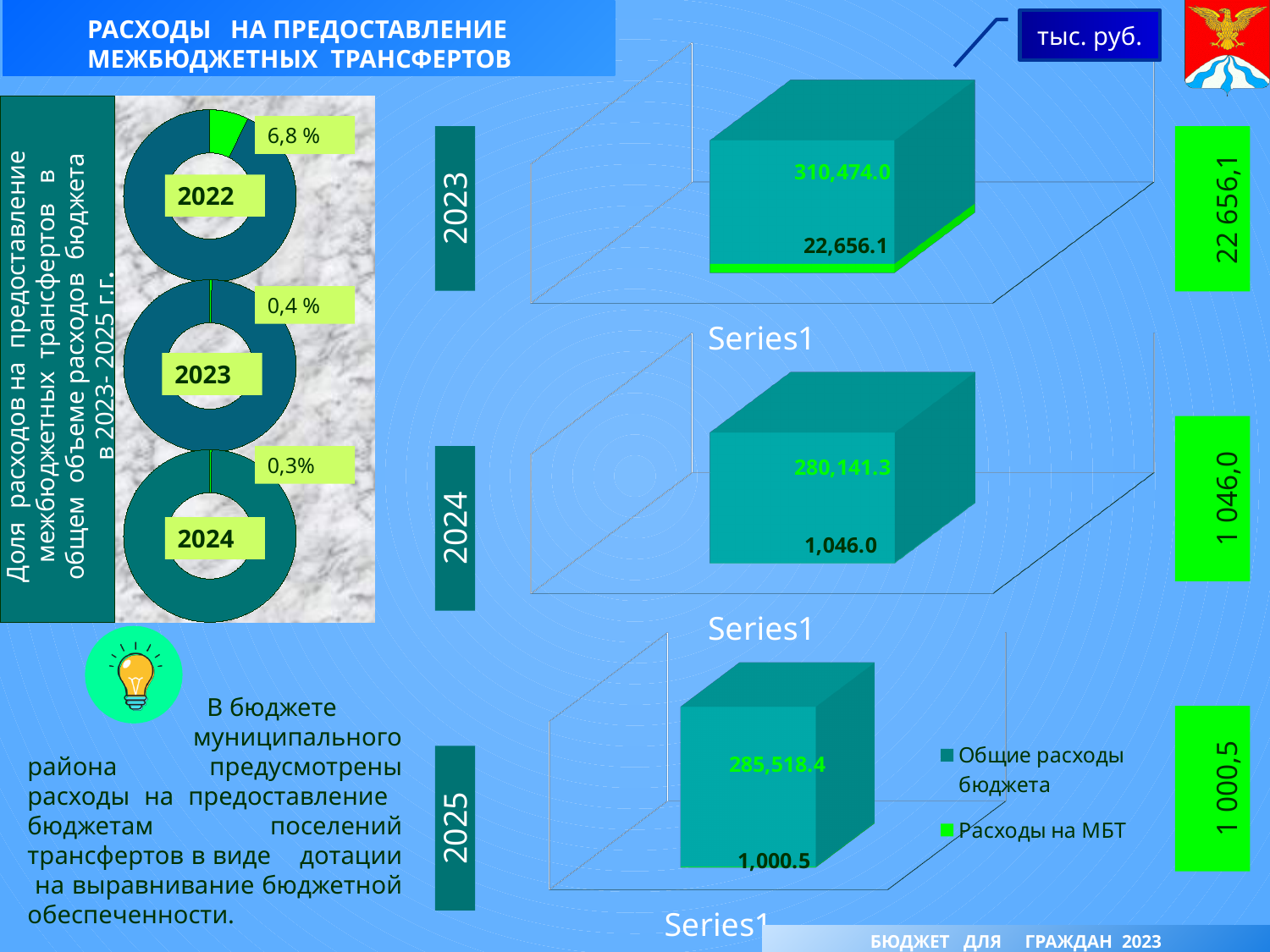
In the 2023 bar chart, which is larger: Общие расходы бюджета or Расходы на МБТ? Общие расходы бюджета What kind of chart is used for the 2023, 2024 and 2025 data on the right side of the slide? bar chart In the 2023 bar chart, what is the value for Расходы на МБТ? 22,656.1 In the 2025 bar chart, what is the value for Общие расходы бюджета? 285,518.4 In the 2023 bar chart, what is the total of the stacked bar (Общие расходы бюджета plus Расходы на МБТ)? 333,130.1 In the 2022 donut chart on the left, what share is shown for the highlighted slice? 6,8 % In the 2024 donut chart on the left, what share is shown for the highlighted slice? 0,3% In the 2024 bar chart, what is the value for Общие расходы бюджета? 280,141.3 In the 2024 bar chart, what is the value for Расходы на МБТ? 1,046.0 In the 2025 bar chart, what is the value for Расходы на МБТ? 1,000.5 How many series does the legend of the bar charts on the right list? 2 In the 2023 bar chart, what is the value for Общие расходы бюджета? 310,474.0